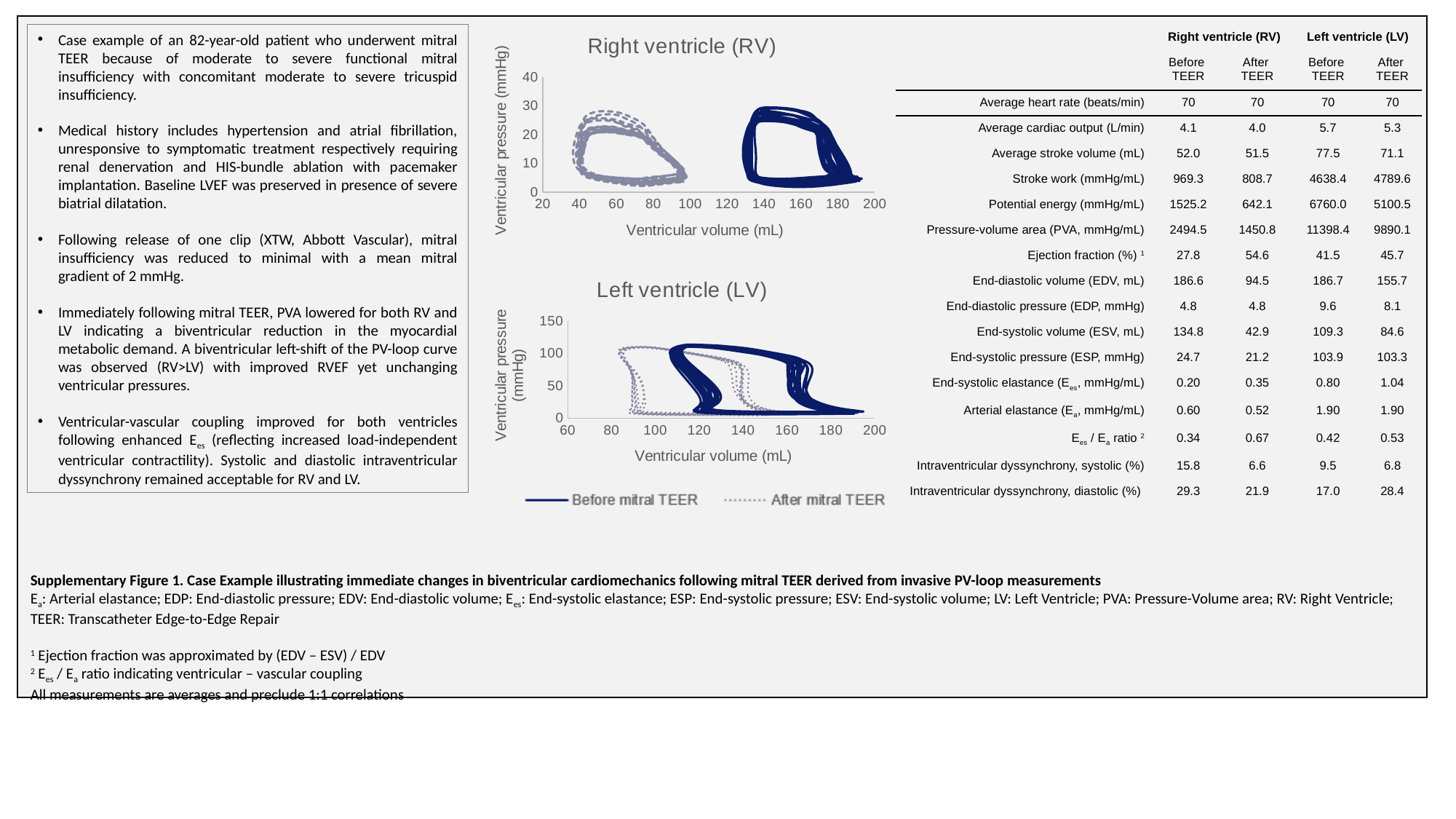
How many series does the legend list for the pressure-volume loop charts? 2 In the Right ventricle (RV) chart, is the peak ventricular pressure of the Before mitral TEER loop greater or less than 20 mmHg? greater In the Left ventricle (LV) chart, is the peak ventricular pressure of the Before mitral TEER loop greater or less than 50 mmHg? greater In the Left ventricle (LV) chart, is the maximum ventricular volume of the Before mitral TEER loop greater or less than 180 mL? greater What kind of chart is the Right ventricle (RV) chart? line chart (pressure-volume loops) What is the x-axis label of the Right ventricle (RV) chart? Ventricular volume (mL) What are the two series named in the legend below the Left ventricle (LV) chart? Before mitral TEER and After mitral TEER In the Left ventricle (LV) chart, which series reaches the larger ventricular volume, Before mitral TEER or After mitral TEER? Before mitral TEER In the Right ventricle (RV) chart, which series has the larger ventricular volumes, Before mitral TEER or After mitral TEER? Before mitral TEER